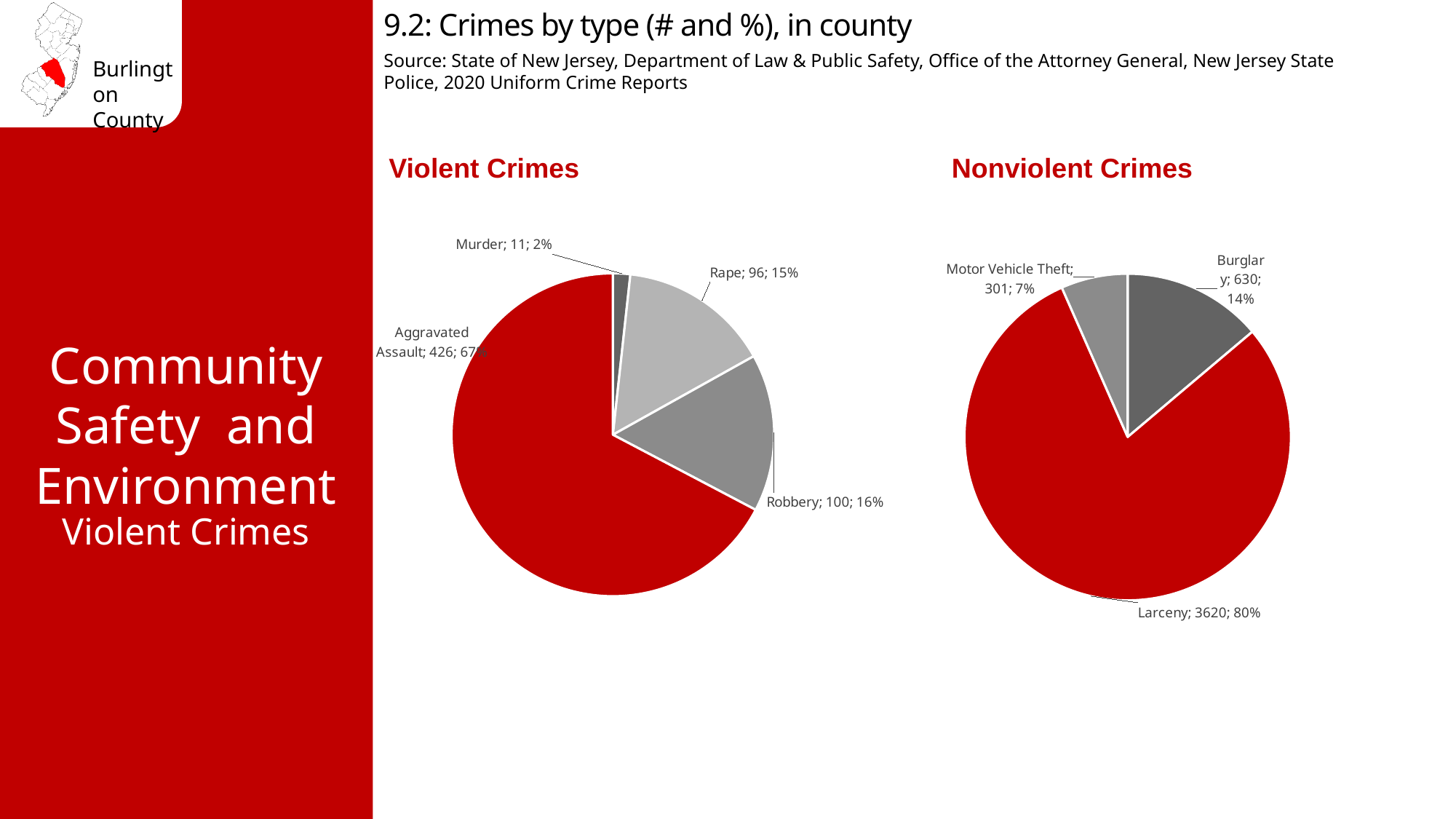
In the Violent Crimes chart, which category has the smallest slice? Murder In the Nonviolent Crimes chart, how many categories are shown? 3 In the Nonviolent Crimes chart, what is the difference between the number of burglaries and the number of motor vehicle thefts? 329 In the Violent Crimes chart, what percentage of violent crimes is robbery? 16% In the Violent Crimes chart, what is the difference between the number of robberies and the number of rapes? 4 In the Violent Crimes chart, how many categories are shown? 4 In the Nonviolent Crimes chart, how many larcenies are shown? 3620 In the Nonviolent Crimes chart, which is larger, the number of burglaries or the number of motor vehicle thefts? Burglary In the Violent Crimes chart, which category has the largest slice? Aggravated Assault In the Nonviolent Crimes chart, what percentage of nonviolent crimes is burglary? 14% In the Violent Crimes chart, how many aggravated assaults are shown? 426 What kind of chart is the Nonviolent Crimes chart? Pie chart